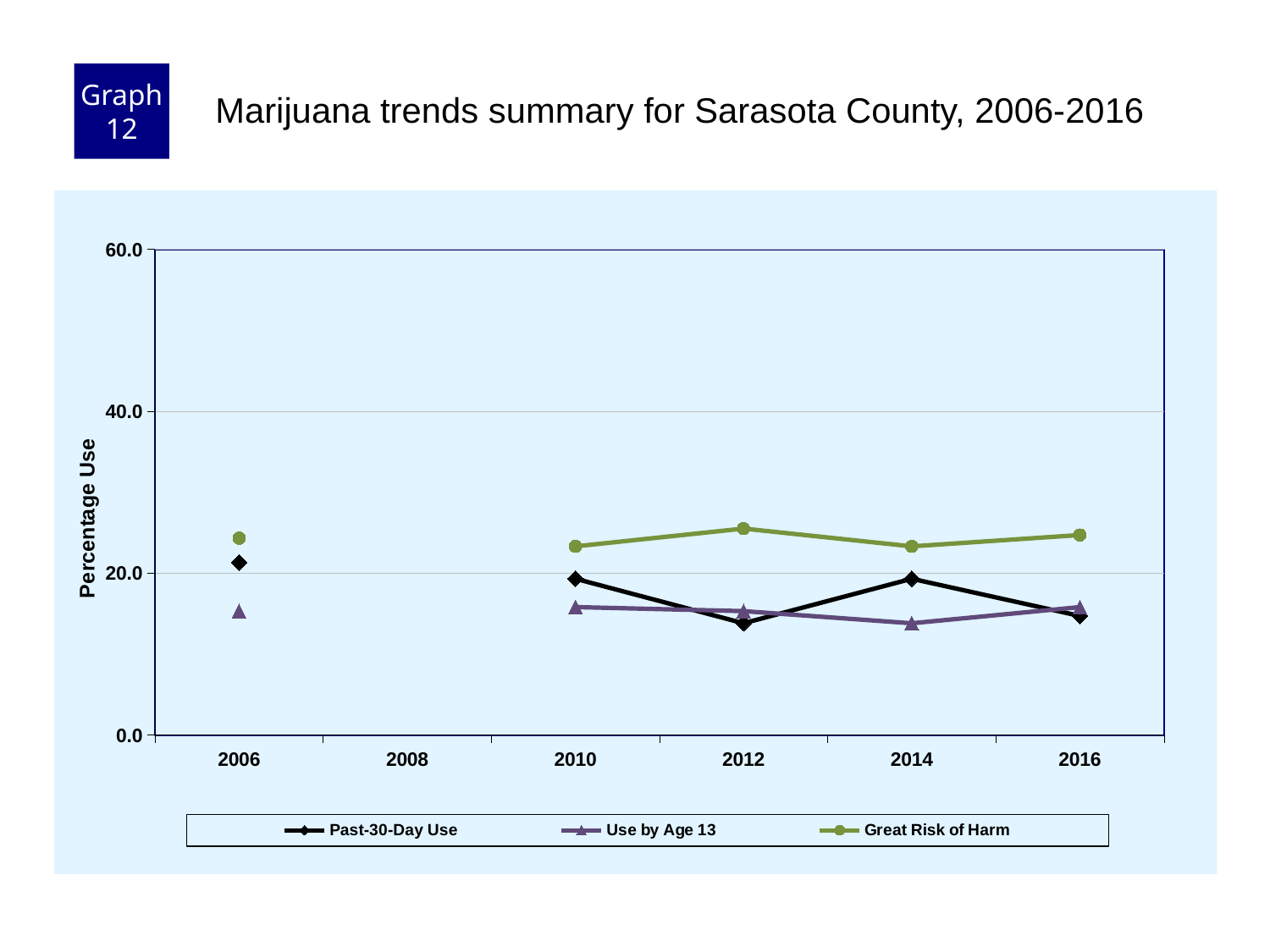
What is the title of the y axis? Percentage Use For Past-30-Day Use, which is larger: the 2014 value or the 2016 value? 2014 Is the value for Great Risk of Harm in 2012 greater or less than 20.0? greater Is the value for Past-30-Day Use in 2012 greater or less than 20.0? less What kind of chart is shown on the slide? line chart Does Past-30-Day Use rise or fall from 2010 to 2012? fall In 2006, which is larger: Past-30-Day Use or Use by Age 13? Past-30-Day Use In which year is Great Risk of Harm at its highest? 2012 How many series does the legend list? 3 In 2012, which is larger: Great Risk of Harm or Past-30-Day Use? Great Risk of Harm Is the value for Great Risk of Harm in 2006 greater or less than 40.0? less What are the three series named in the legend? Past-30-Day Use, Use by Age 13, Great Risk of Harm